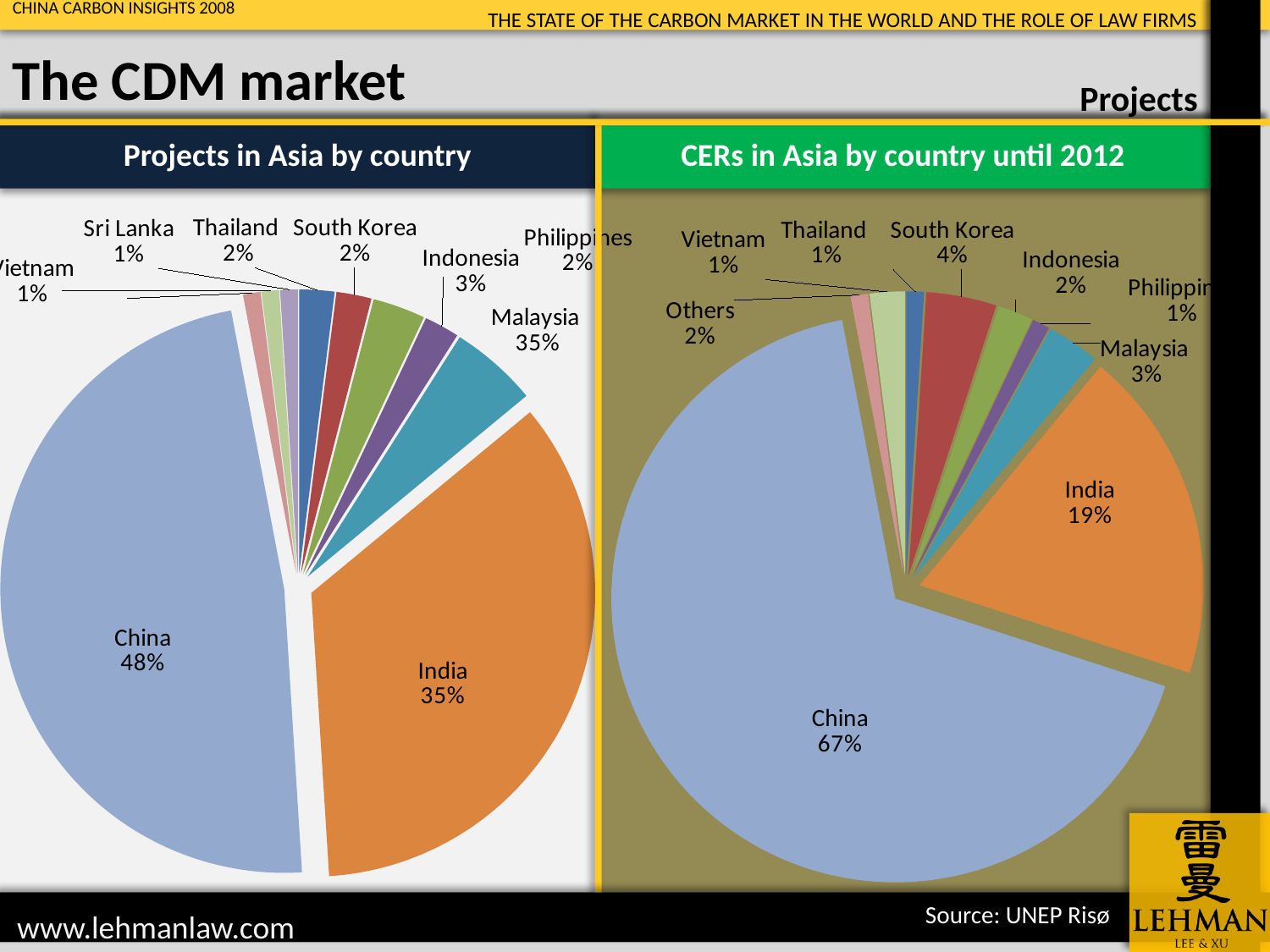
In the 'CERs in Asia by country until 2012' chart, which country has the largest slice? China In the 'CERs in Asia by country until 2012' chart, what share does China hold? 67% In the 'CERs in Asia by country until 2012' chart, what is the difference between China's share and India's share? 48% How many slices does the 'CERs in Asia by country until 2012' pie chart have? 9 In the 'Projects in Asia by country' chart, what share of projects does China account for? 48% In the 'Projects in Asia by country' chart, what share of projects does India account for? 35% In the 'CERs in Asia by country until 2012' chart, what share does South Korea hold? 4% In the 'CERs in Asia by country until 2012' chart, which is larger, Malaysia's share or Indonesia's share? Malaysia In the 'CERs in Asia by country until 2012' chart, what share does India hold? 19% In the 'Projects in Asia by country' chart, which country has the largest slice? China In the 'Projects in Asia by country' chart, what is the difference between China's share and India's share? 13% What type of chart is used for 'Projects in Asia by country'? Pie chart